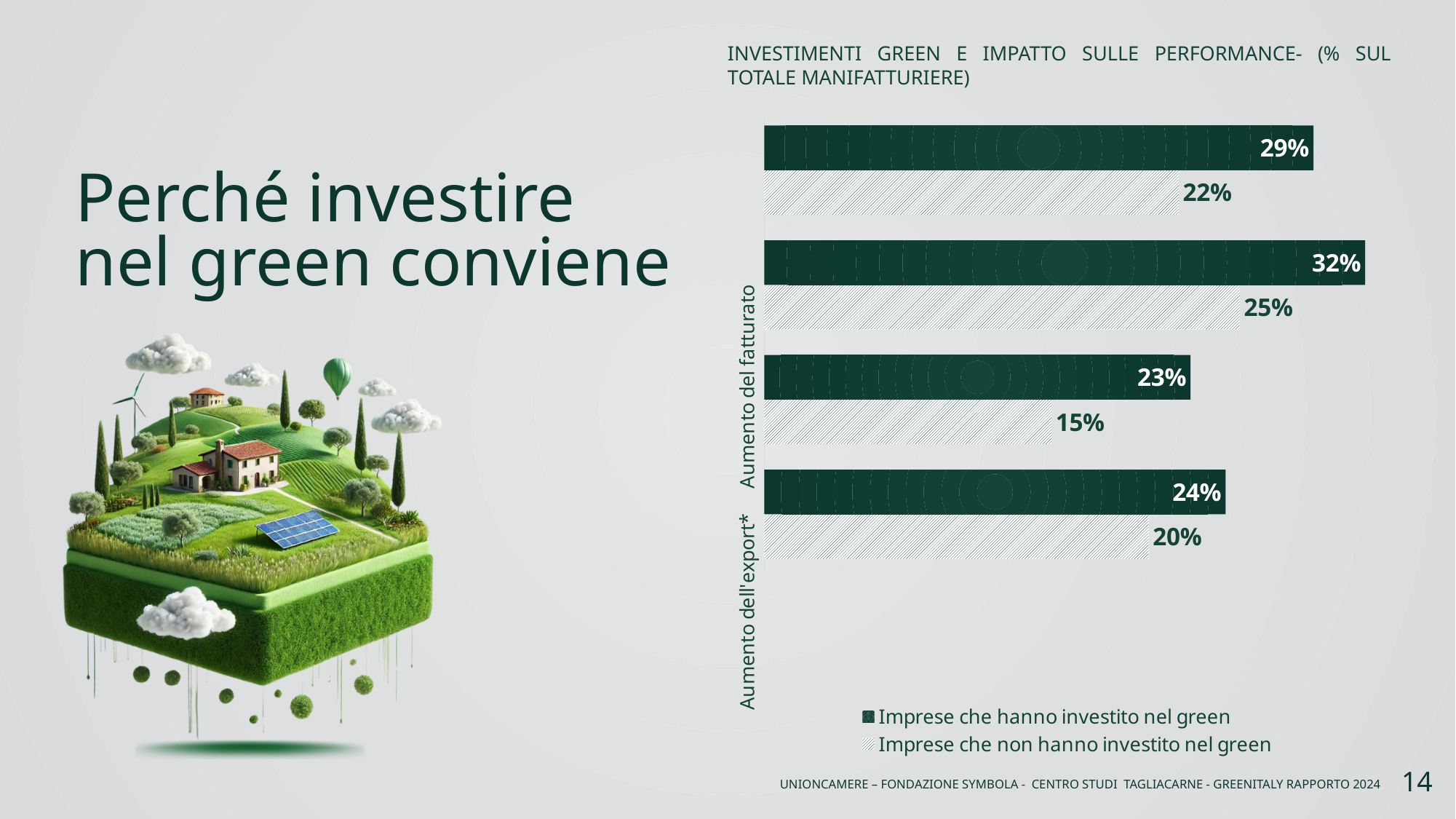
What kind of chart is shown on the slide? bar chart What is the value of the hatched bar in the bottom pair of bars? 20% What is the value of the hatched bar in the topmost pair of bars? 22% What is the highest value shown among the dark green bars (Imprese che hanno investito nel green)? 32% What is the value of the dark green bar in the topmost pair of bars? 29% Which series does the hatched pattern represent in the legend? Imprese che non hanno investito nel green What is the value of the dark green bar in the second pair of bars from the top? 32% What is the lowest value shown among the hatched bars (Imprese che non hanno investito nel green)? 15% What is the difference between the dark green bar and the hatched bar in the third pair of bars from the top (23% vs 15%)? 8% What is the value of the hatched bar in the third pair of bars from the top? 15% How many series does the chart legend list? 2 In the bottom pair of bars, which is larger: the dark green bar or the hatched bar? the dark green bar (24%)